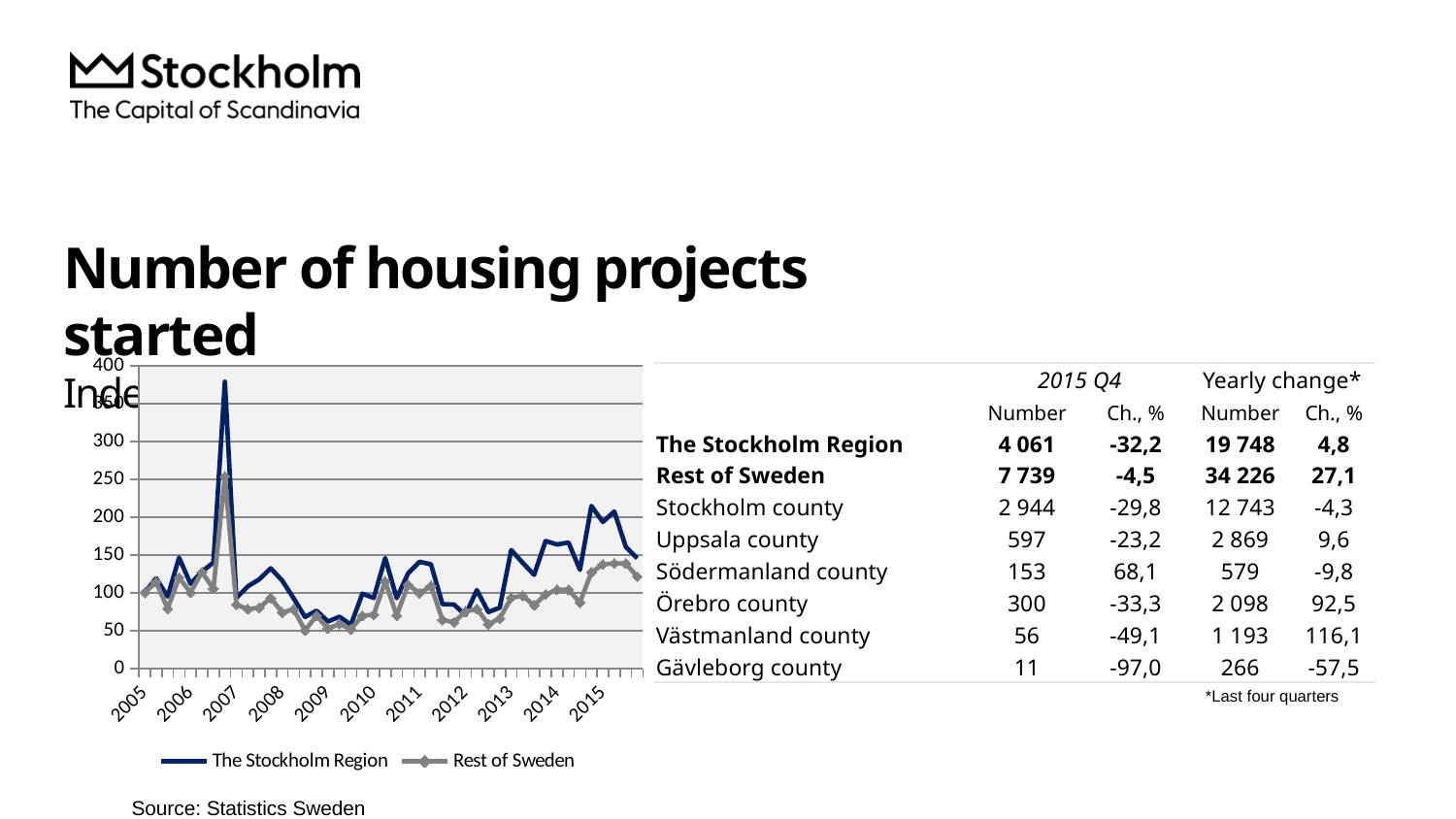
How many series does the chart legend list? 2 How many year labels are shown on the x axis of the chart? 11 Around 2009, is the value of The Stockholm Region series greater or less than 100? less Which series is drawn with the dark blue line? The Stockholm Region Is the peak value of The Stockholm Region series in 2007 greater or less than 300? greater What are the two series named in the chart legend? The Stockholm Region and Rest of Sweden Is the peak value of the Rest of Sweden series in 2007 greater or less than 200? greater From 2009 to 2015, does The Stockholm Region series generally rise or fall? rise In 2014, which series is higher, The Stockholm Region or Rest of Sweden? The Stockholm Region What kind of chart is shown on the slide? line chart At the 2007 peak, which series has the higher value, The Stockholm Region or Rest of Sweden? The Stockholm Region